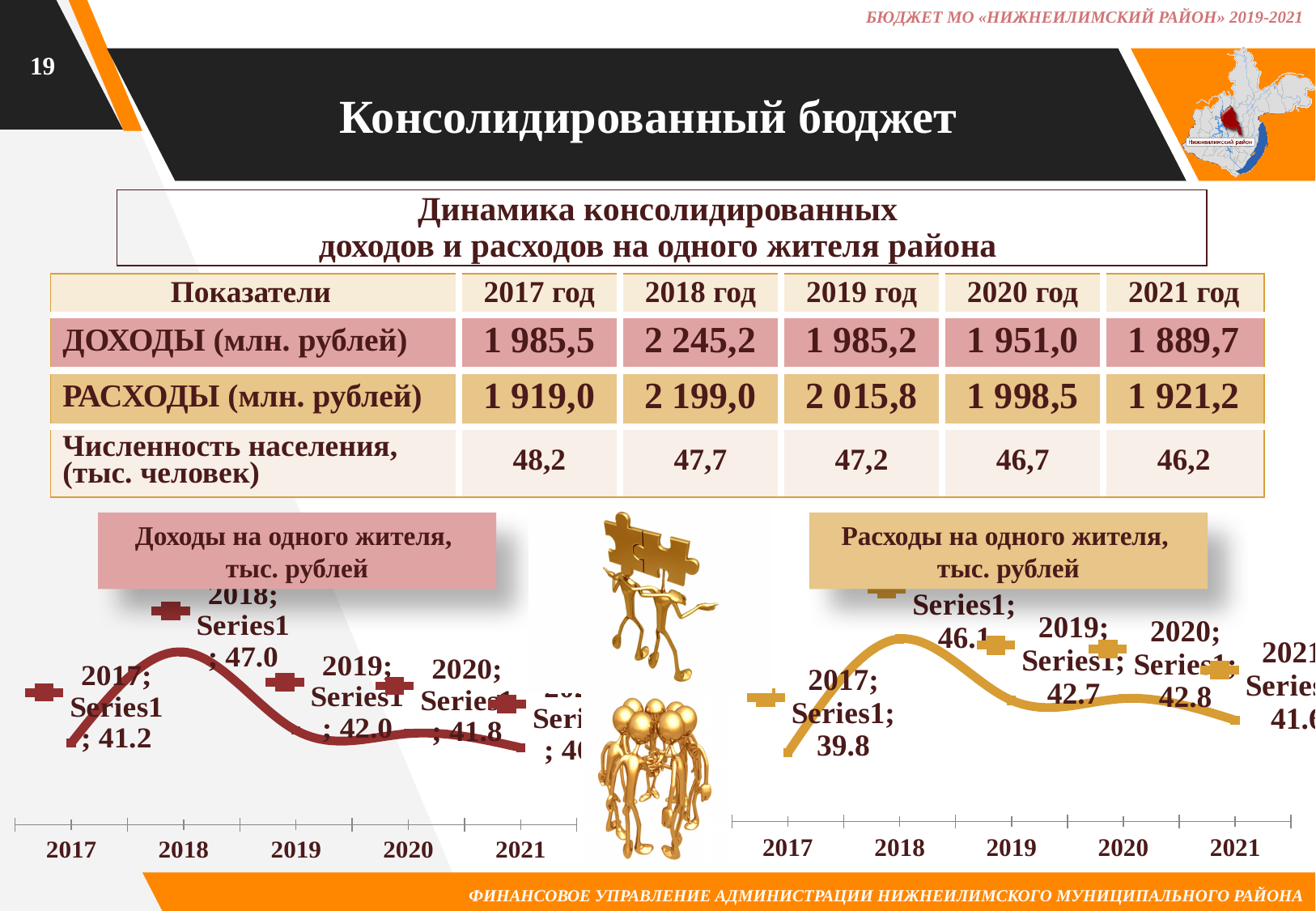
In the chart 'Доходы на одного жителя, тыс. рублей', which year has the highest value? 2018 In the chart 'Доходы на одного жителя, тыс. рублей', what is the difference between the 2018 and 2017 values? 5.8 In the chart 'Расходы на одного жителя, тыс. рублей', what is the value for 2017? 39.8 In the chart 'Расходы на одного жителя, тыс. рублей', does the value rise or fall from 2017 to 2018? rise In the chart 'Доходы на одного жителя, тыс. рублей', what is the value for 2017? 41.2 What kind of chart is 'Доходы на одного жителя, тыс. рублей'? line chart In the chart 'Доходы на одного жителя, тыс. рублей', what is the value for 2018? 47.0 In the chart 'Расходы на одного жителя, тыс. рублей', what is the difference between the 2018 and 2017 values? 6.3 In the chart 'Расходы на одного жителя, тыс. рублей', which year has the highest value? 2018 In the chart 'Расходы на одного жителя, тыс. рублей', what is the value for 2019? 42.7 In the chart 'Доходы на одного жителя, тыс. рублей', which is larger, the value for 2018 or the value for 2019? 2018 How many years are plotted in the chart 'Расходы на одного жителя, тыс. рублей'? 5